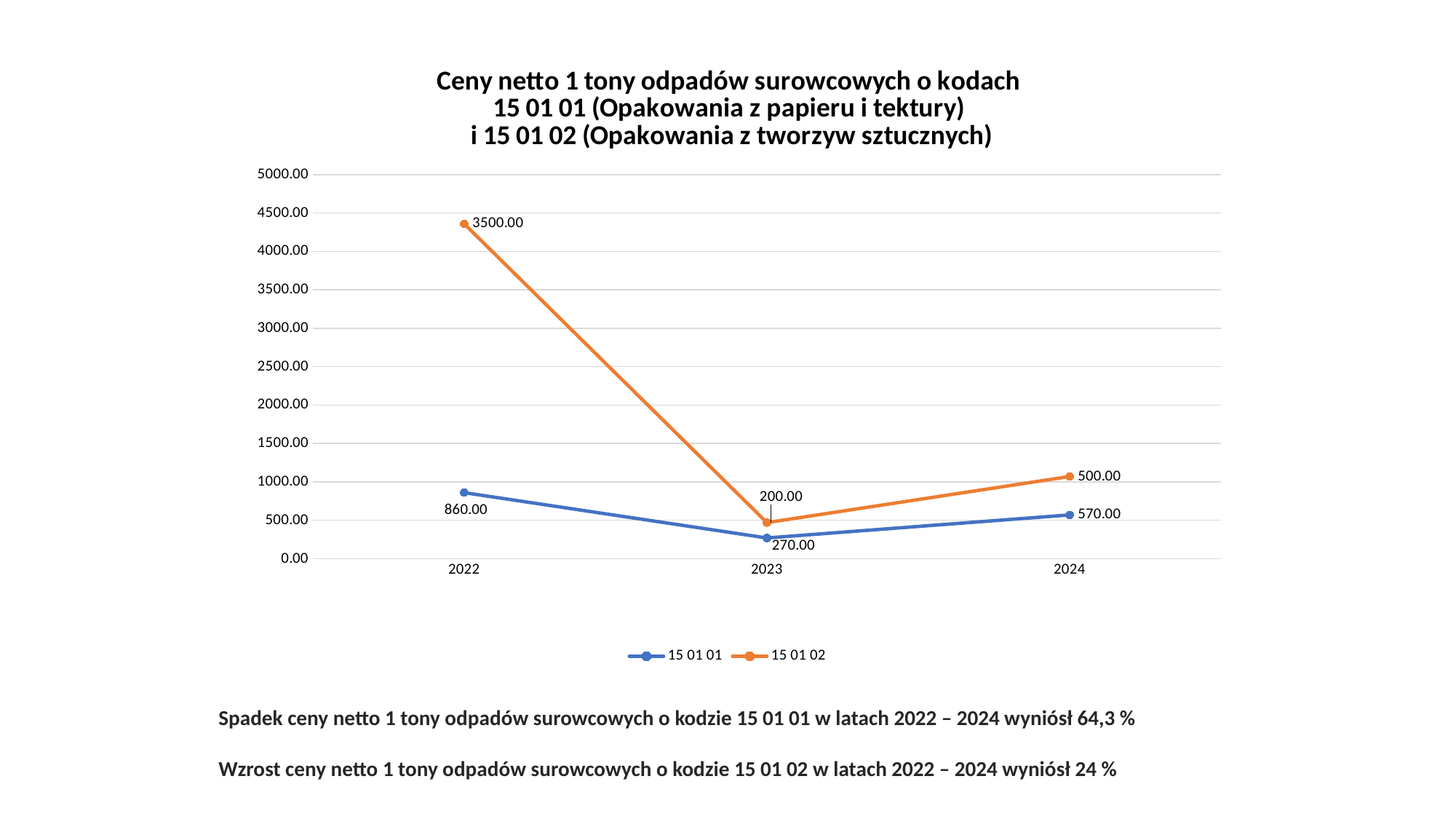
How many years are shown on the x axis? 3 In which year is the value for series 15 01 01 lowest? 2023 What is the value for series 15 01 01 in 2022? 860.00 What is the value for series 15 01 01 in 2023? 270.00 What is the data label for series 15 01 02 in 2024? 500.00 What type of chart is shown on the slide? line chart How many series does the legend list? 2 What is the data label for series 15 01 02 in 2022? 3500.00 Which colour is used for the 15 01 02 series line? orange Which series has the higher value in 2022, 15 01 01 or 15 01 02? 15 01 02 What is the difference between the 2022 and 2024 values for series 15 01 01? 290.00 What is the value for series 15 01 01 in 2024? 570.00